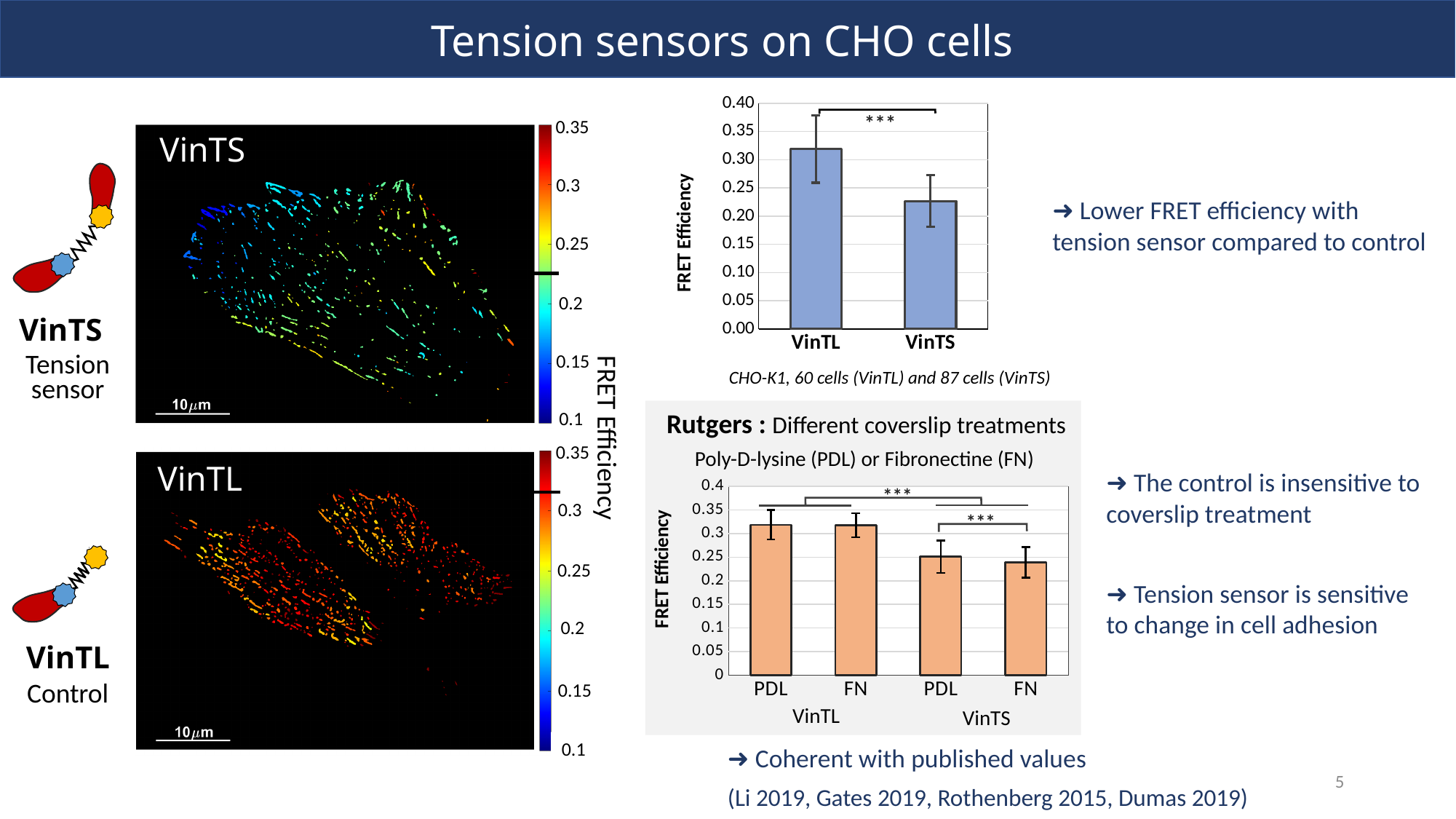
In the top-right chart, is the FRET efficiency for VinTL greater or less than 0.30? greater How many bars are plotted in the bottom-right Rutgers chart? 4 How many bars are plotted in the top-right chart? 2 What kind of chart is the top-right chart comparing VinTL and VinTS? bar chart In the top-right chart, is the FRET efficiency for VinTS greater or less than 0.25? less In the top-right chart, which category has the higher FRET efficiency, VinTL or VinTS? VinTL In the bottom-right Rutgers chart, which is larger, the FRET efficiency for VinTL on FN or for VinTS on FN? VinTL on FN In the bottom-right Rutgers chart, is the FRET efficiency for VinTL on PDL greater or less than 0.3? greater What is the y-axis label of the top-right chart? FRET Efficiency What are the two coverslip treatments named in the bottom-right Rutgers chart? PDL and FN In the top-right chart, which category has the lowest FRET efficiency? VinTS